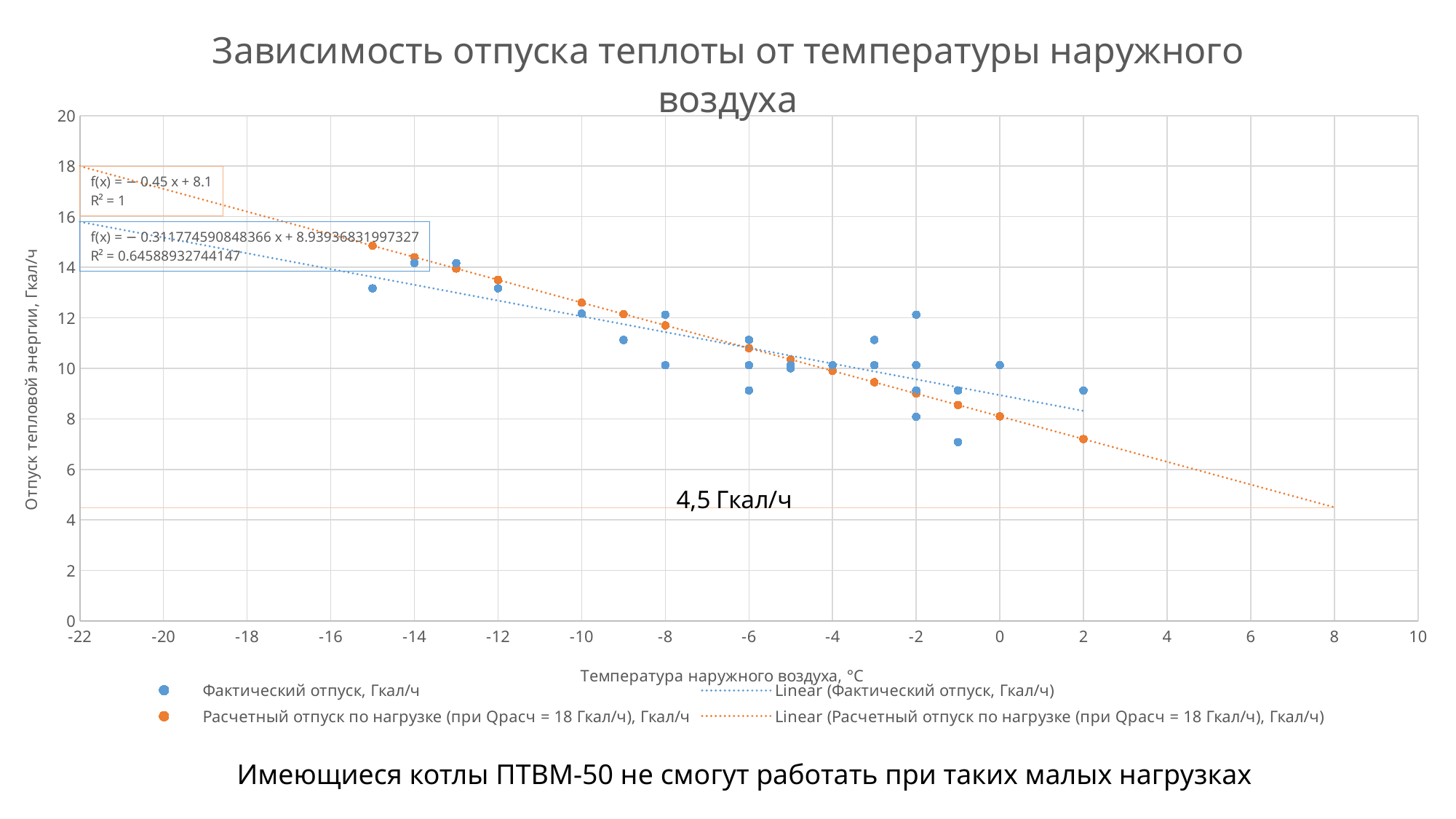
How many entries does the chart legend list? 4 What kind of chart is shown on the slide? Scatter chart Do the values of the Расчетный отпуск по нагрузке series rise or fall as the outdoor air temperature increases along the x axis? Fall What is the R² value shown for the blue trendline (Фактический отпуск)? 0.64588932744147 What is the R² value shown for the orange trendline (Расчетный отпуск по нагрузке)? 1 What is the title of the y axis? Отпуск тепловой энергии, Гкал/ч Is the Фактический отпуск value at −15 °C greater or less than 14? less What is the slope of the trendline for the Фактический отпуск series? −0.311774590848366 Is the Расчетный отпуск по нагрузке value at 2 °C greater or less than 8? less What is the trendline equation shown for the Расчетный отпуск по нагрузке series? f(x) = −0.45 x + 8.1 What is the title of the chart? Зависимость отпуска теплоты от температуры наружного воздуха Is the Расчетный отпуск по нагрузке value at −10 °C greater or less than 12? greater